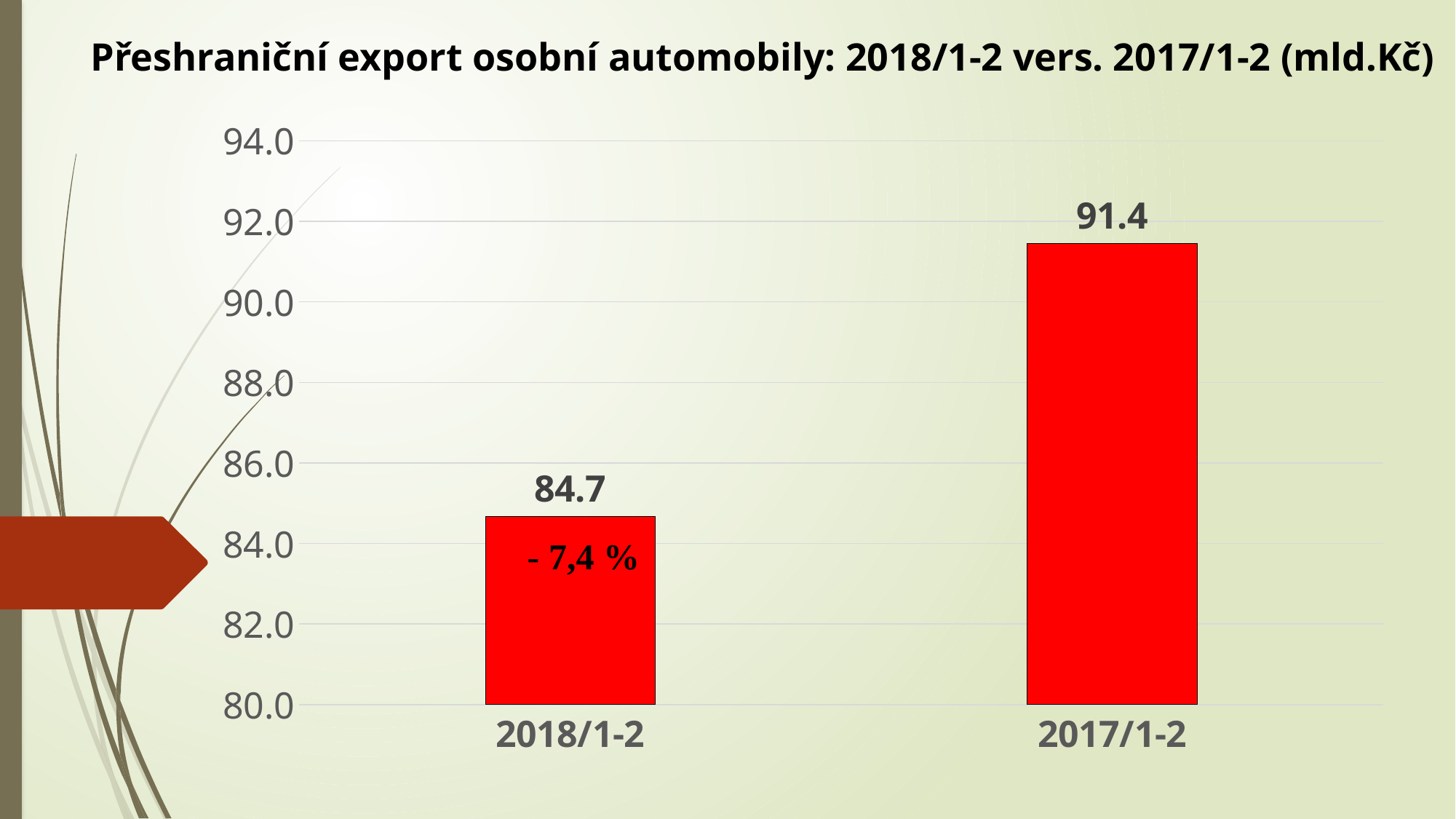
Is the value for 2017/1-2 greater or less than 90.0? greater Which category has the lowest value? 2018/1-2 Which is larger, the value for 2018/1-2 or the value for 2017/1-2? 2017/1-2 What is the difference between the values for 2017/1-2 and 2018/1-2? 6.7 How many categories are shown on the x axis? 2 What kind of chart is shown on the slide? bar chart What unit is given in the chart title? mld.Kč What percentage change is printed inside the 2018/1-2 bar? - 7,4 % Which category has the highest value? 2017/1-2 Is the value for 2018/1-2 greater or less than 86.0? less What is the value for 2018/1-2? 84.7 What is the value for 2017/1-2? 91.4